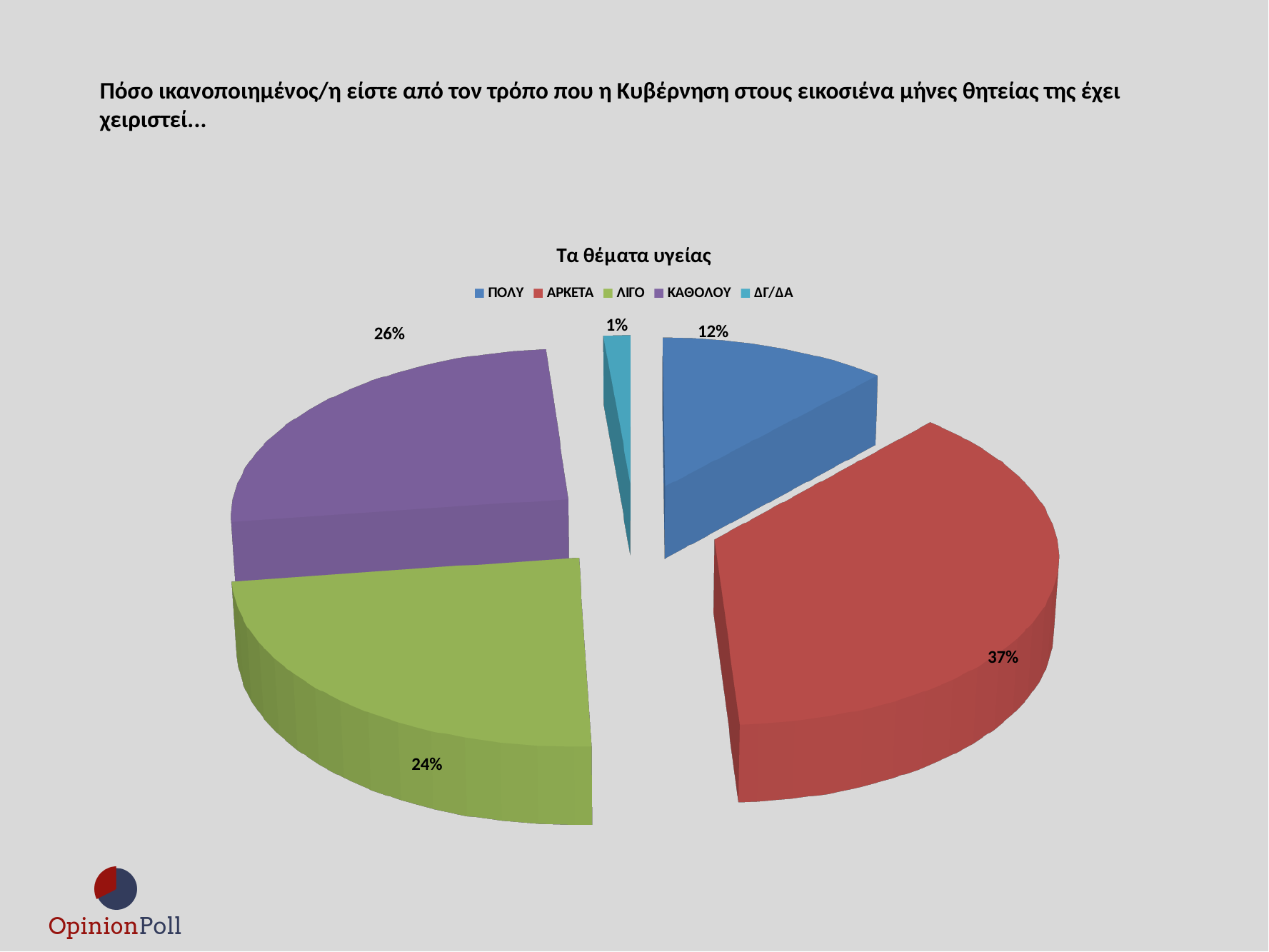
What kind of chart is shown? Pie chart What is the title of the chart? Τα θέματα υγείας What percentage of the pie is ΔΓ/ΔΑ? 1% What percentage of the pie is ΛΙΓΟ? 24% What is the difference between the ΑΡΚΕΤΑ and ΚΑΘΟΛΟΥ shares? 11% What percentage of the pie is ΠΟΛΥ? 12% Which category has the smallest slice? ΔΓ/ΔΑ Which is larger, the ΚΑΘΟΛΟΥ slice or the ΛΙΓΟ slice? ΚΑΘΟΛΟΥ What percentage of the pie is ΑΡΚΕΤΑ? 37% What percentage of the pie is ΚΑΘΟΛΟΥ? 26% Which category has the largest slice? ΑΡΚΕΤΑ How many categories does the legend list? 5